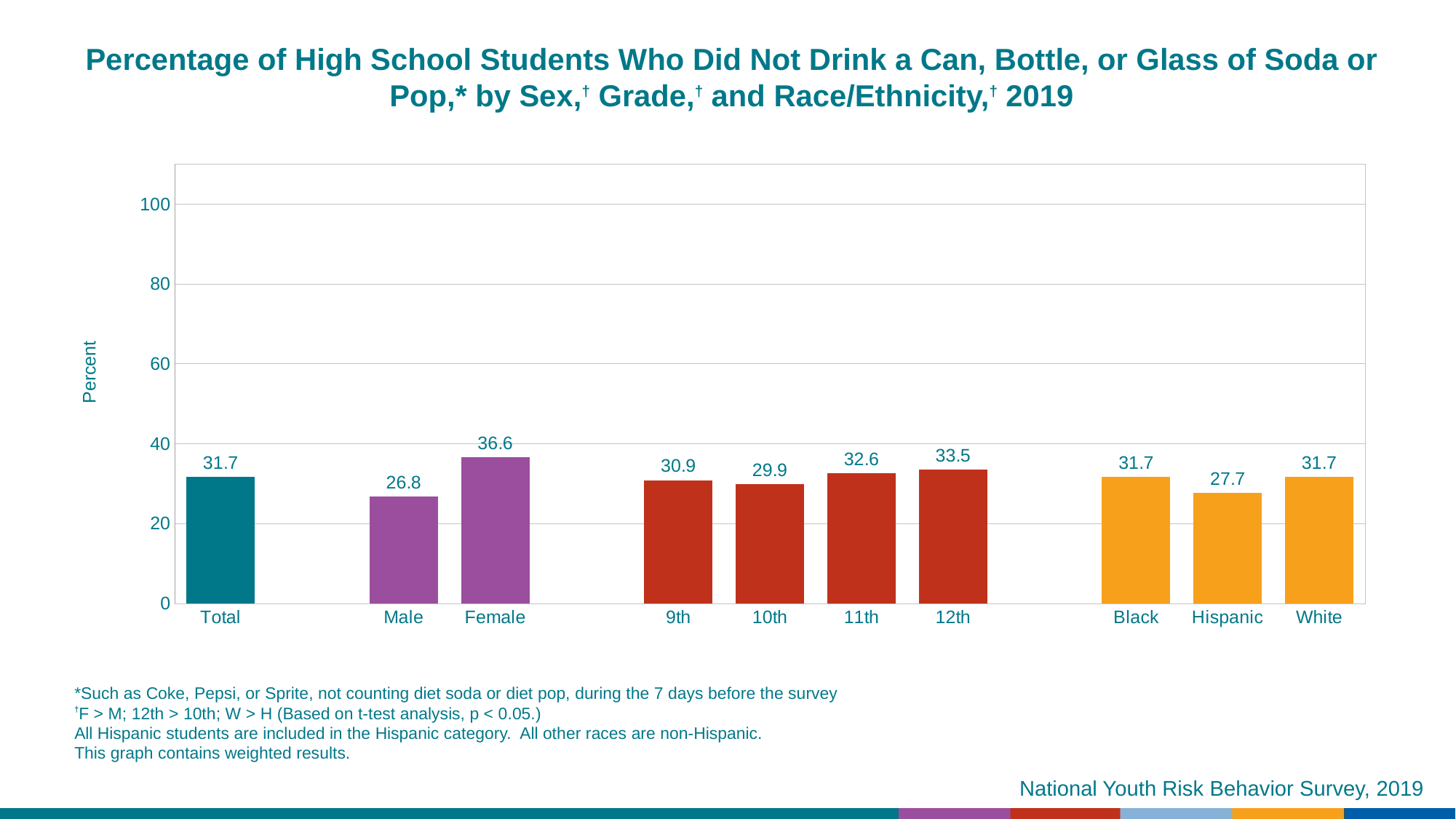
How many categories are shown on the x axis? 10 Is the value for Female greater or less than 40? less What is the value for Female? 36.6 Which category has the highest value? Female Which category has the lowest value? Male What is the label on the y axis? Percent What kind of chart is this? bar chart What is the value for Hispanic? 27.7 What is the difference between the Female and Male values? 9.8 What is the value for 10th grade? 29.9 Do the values rise or fall from 9th grade to 12th grade, ignoring 10th grade? rise Which is larger, the value for 12th grade or the value for 9th grade? 12th